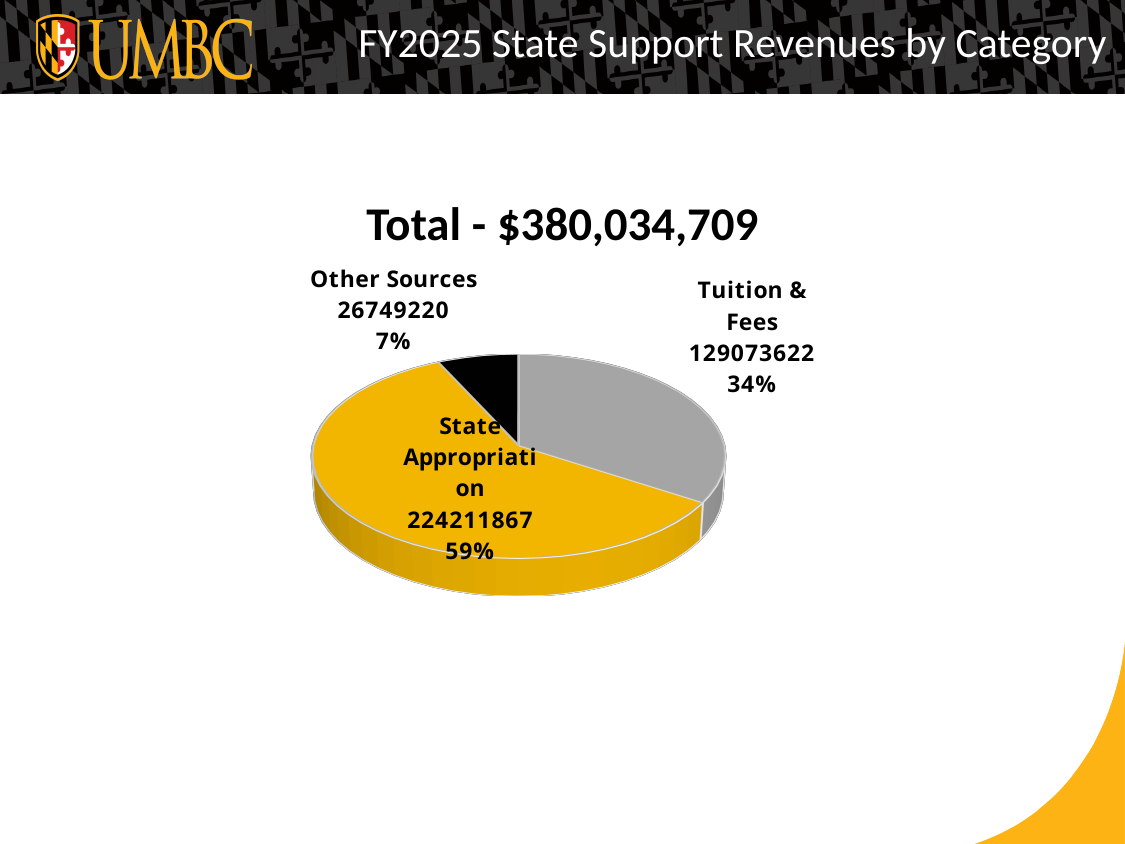
What share of the pie does Other Sources represent? 7% What is the value shown for Tuition & Fees? 129073622 What total is shown in the chart title? $380,034,709 What is the value shown for State Appropriation? 224211867 What is the value shown for Other Sources? 26749220 What is the difference between the State Appropriation value and the Tuition & Fees value? 95138245 What share of the pie does Tuition & Fees represent? 34% What kind of chart is shown on the slide? pie chart Which category has the largest slice of the pie? State Appropriation Which is larger, Tuition & Fees or Other Sources? Tuition & Fees How many slices does the pie chart have? 3 Which category has the smallest slice of the pie? Other Sources